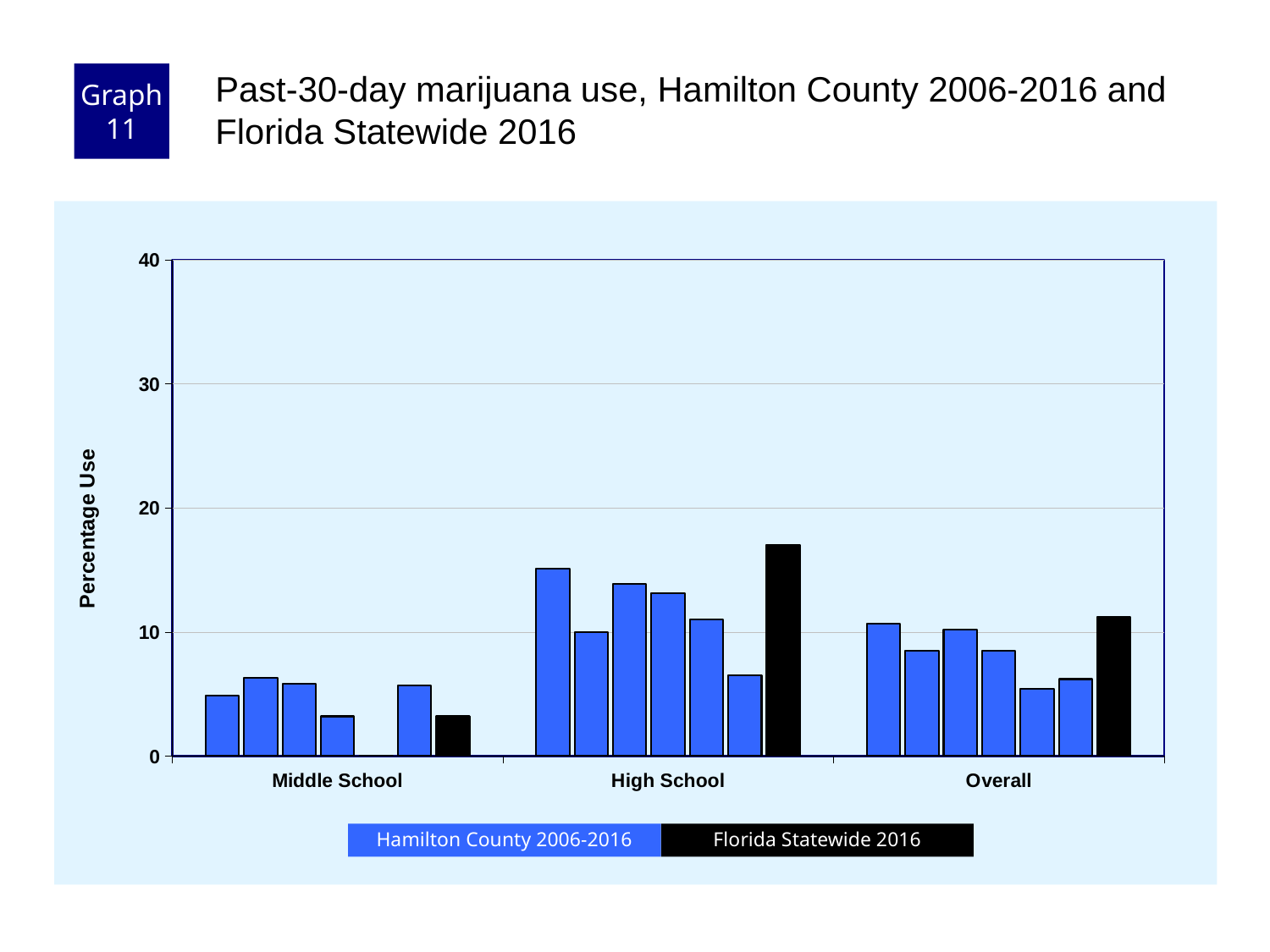
Are all the Hamilton County 2006-2016 bars for Middle School greater or less than 10? less Which category has the highest Florida Statewide 2016 value? High School Is the Florida Statewide 2016 value for Middle School greater or less than 10? less Is the Florida Statewide 2016 value for High School greater or less than 10? greater What kind of chart is shown on the slide? bar chart Which is larger, the Florida Statewide 2016 value for High School or for Overall? High School Which category has the lowest Florida Statewide 2016 value? Middle School What is the label on the y axis? Percentage Use How many categories are shown on the x axis? 3 What colour are the Florida Statewide 2016 bars? black How many series does the legend list? 2